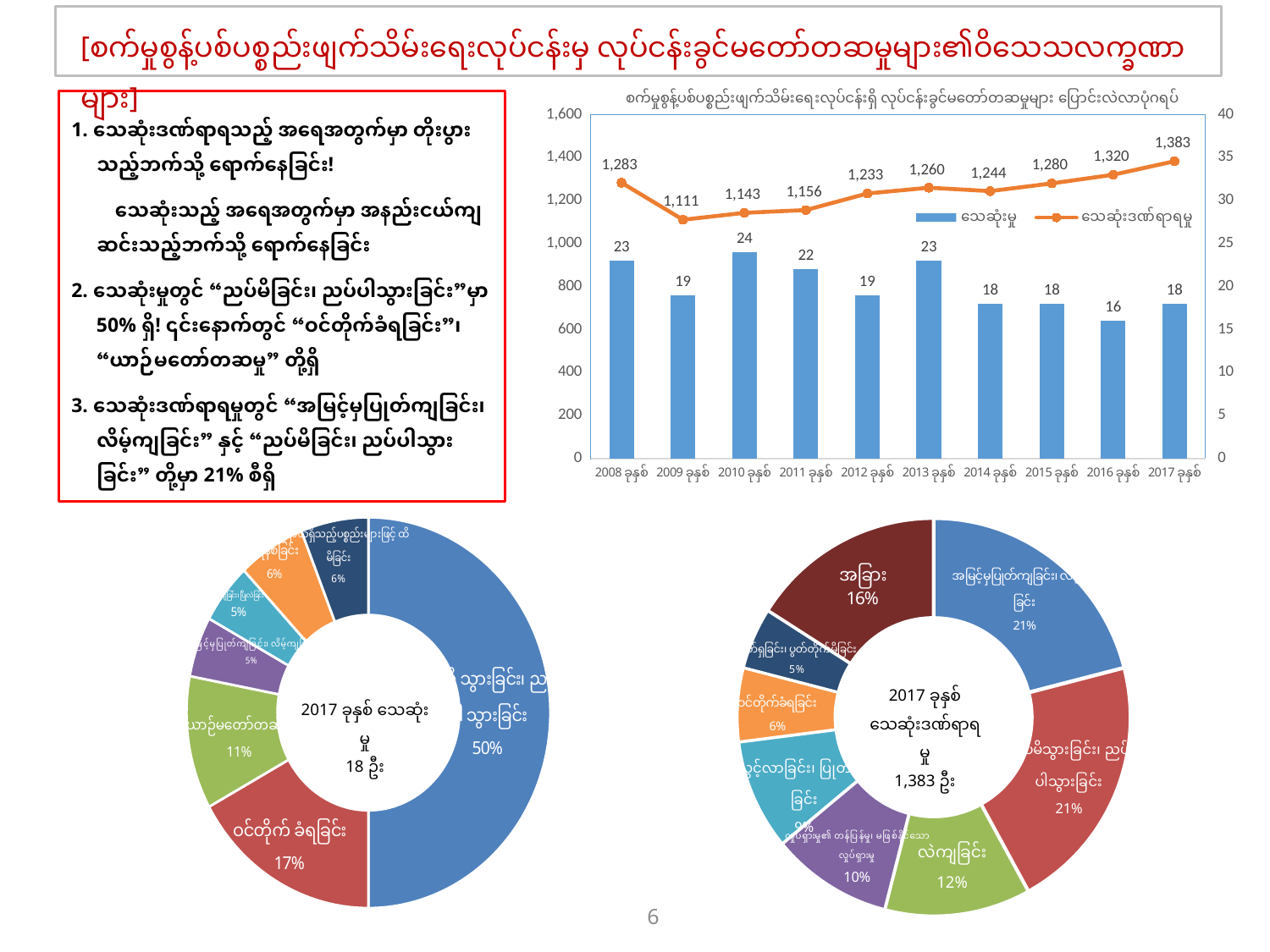
In the top-right chart, is the bar value for 2008 ခုနှစ် larger or smaller than the bar value for 2009 ခုနှစ်? larger What kind of chart is shown at the bottom left of the slide? Doughnut (pie) chart In the top-right chart, what is the line value for 2017 ခုနှစ်? 1,383 In the bottom-left doughnut chart, what share does the largest slice have? 50% In the top-right chart, how many series does the legend list? 2 In the top-right chart, which year has the highest line value? 2017 ခုနှစ် In the bottom-right doughnut chart, what total is printed in the centre? 1,383 ဦး In the top-right chart, what is the difference between the line values for 2017 ခုနှစ် and 2016 ခုနှစ်? 63 In the top-right chart, how many years are shown on the x axis? 10 In the top-right chart, which year has the lowest bar value? 2016 ခုနှစ် In the top-right chart, what is the bar value for 2010 ခုနှစ်? 24 In the top-right chart, does the line series generally rise or fall from 2009 ခုနှစ် to 2017 ခုနှစ်? rise